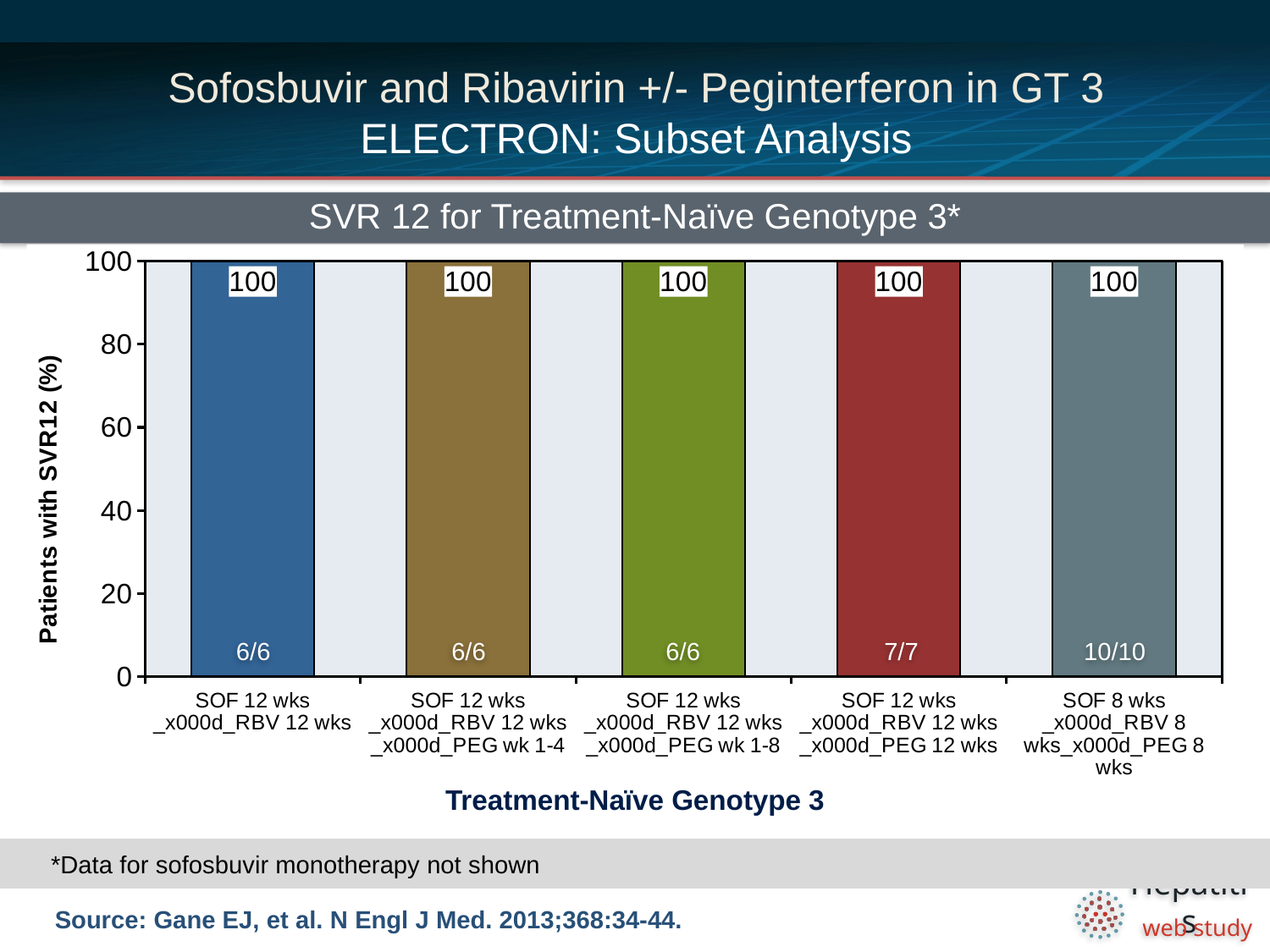
What is the SVR12 rate (%) for the SOF 12 wks + RBV 12 wks group? 100 How many patients achieved SVR12 in the SOF 12 wks + RBV 12 wks + PEG 12 wks group, as shown on the bar? 7/7 How many bars (treatment groups) are shown in the chart? 5 What is the difference in SVR12 rate between the SOF 12 wks + RBV 12 wks group and the SOF 8 wks + RBV 8 wks + PEG 8 wks group? 0 Do the SVR12 rates rise, fall, or stay the same across the treatment groups from left to right? Stay the same What is the SVR12 rate (%) for the SOF 8 wks + RBV 8 wks + PEG 8 wks group? 100 What is the SVR12 rate (%) for the SOF 12 wks + RBV 12 wks + PEG 12 wks group? 100 How many patients achieved SVR12 in the SOF 8 wks + RBV 8 wks + PEG 8 wks group, as shown on the bar? 10/10 What kind of chart is shown on the slide? Bar chart What is the label of the y-axis? Patients with SVR12 (%) How many patients achieved SVR12 in the SOF 12 wks + RBV 12 wks + PEG wk 1-4 group, as shown on the bar? 6/6 What is the title of the chart? SVR 12 for Treatment-Naïve Genotype 3*